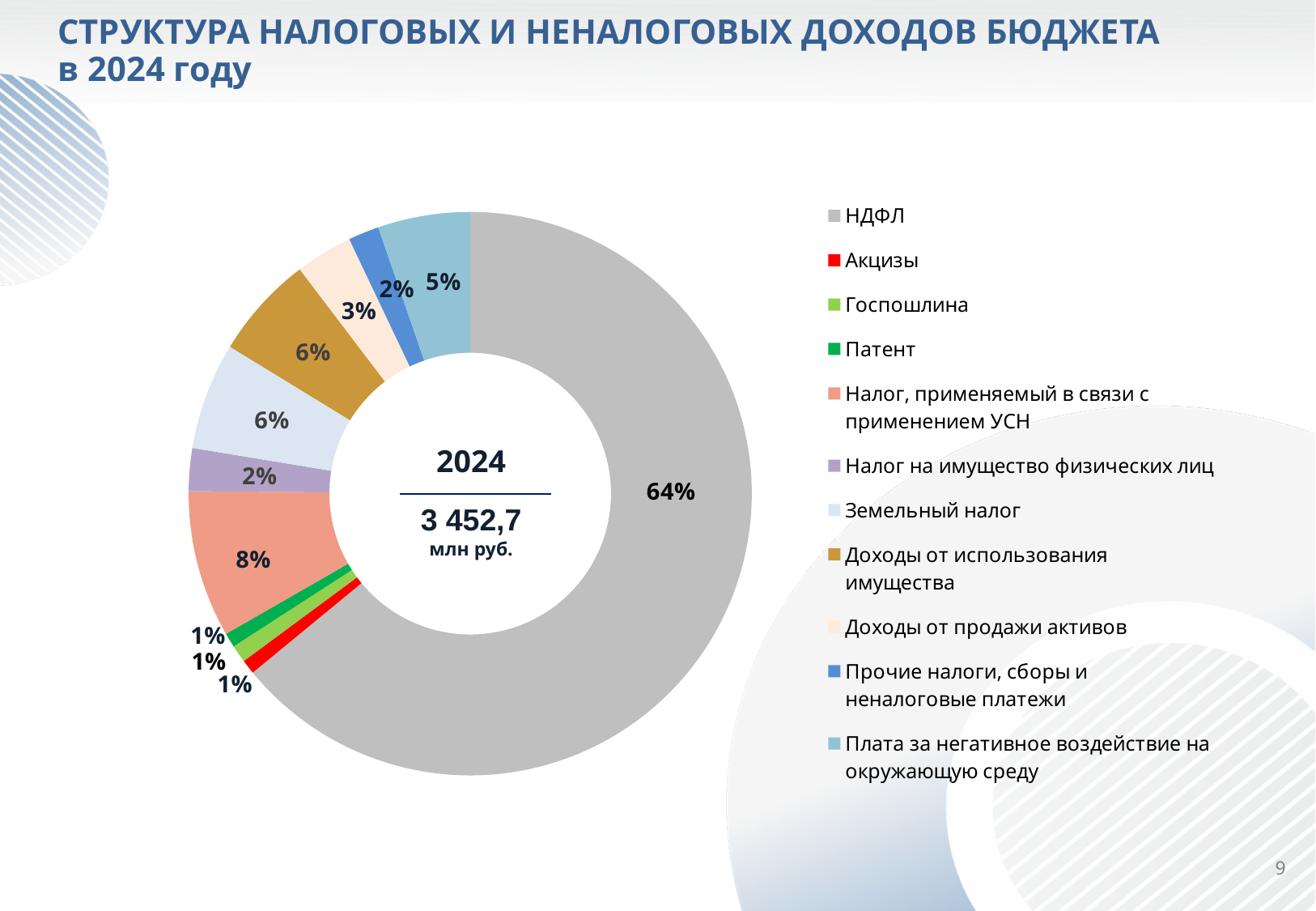
What is the difference in percentage points between the share of НДФЛ and the share of Налог, применяемый в связи с применением УСН? 56 What kind of chart is shown on the slide? Doughnut (pie) chart How many categories does the legend list? 11 What share is shown for Доходы от продажи активов? 3% What total amount in млн руб. is shown in the centre of the chart? 3 452,7 What share of the budget revenue does НДФЛ account for? 64% Which category has the largest share of the budget revenue? НДФЛ What year is shown in the centre of the chart? 2024 What share is shown for Плата за негативное воздействие на окружающую среду? 5% What share is shown for Земельный налог? 6% What share is shown for Налог, применяемый в связи с применением УСН? 8% Which has a larger share: Доходы от продажи активов or Плата за негативное воздействие на окружающую среду? Плата за негативное воздействие на окружающую среду